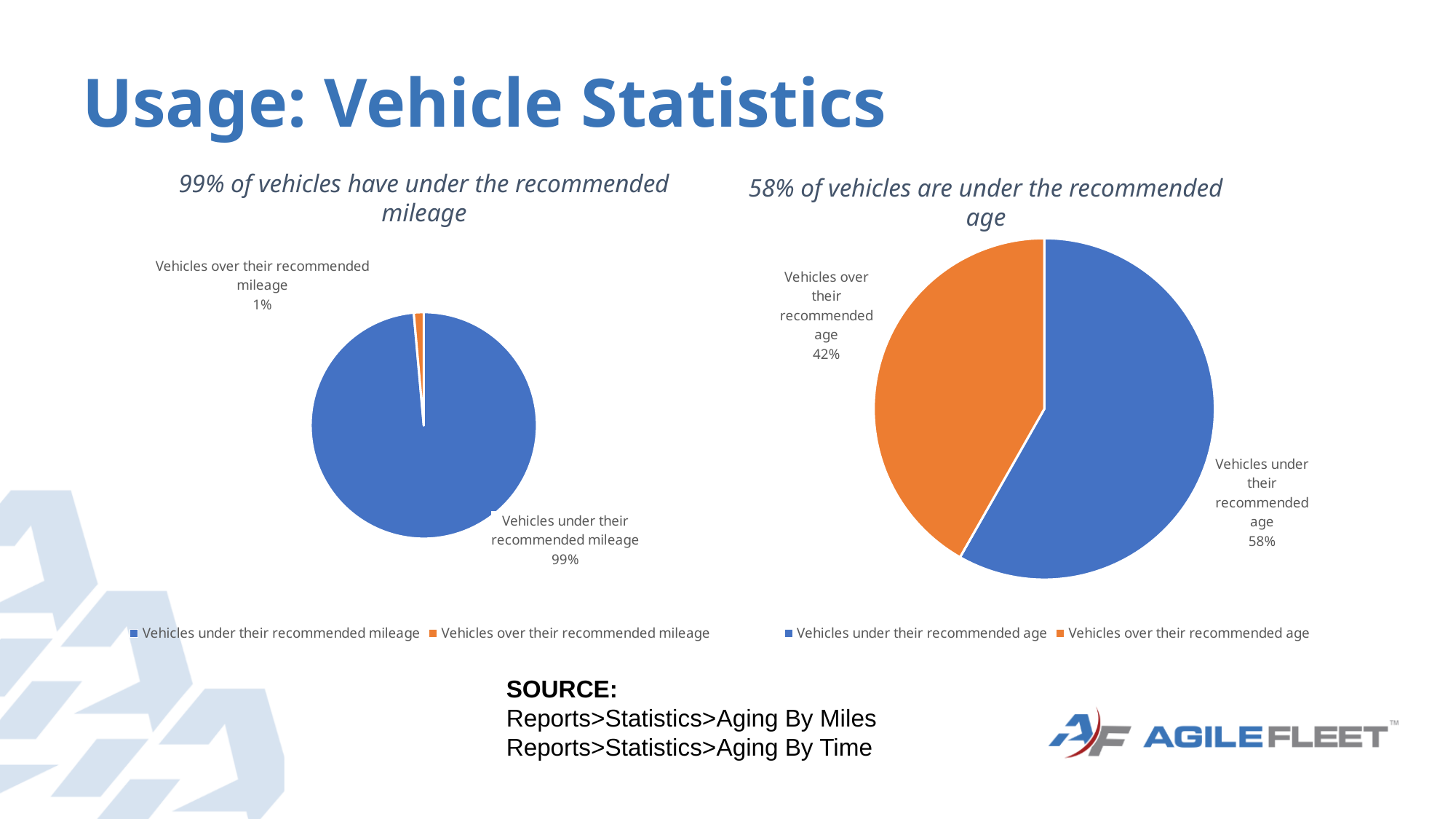
In the right chart (58% of vehicles are under the recommended age), which slice is the largest? Vehicles under their recommended age In the left chart (99% of vehicles have under the recommended mileage), what is the difference in percentage points between vehicles under and over their recommended mileage? 98 In the right chart (58% of vehicles are under the recommended age), what is the difference in percentage points between vehicles under and over their recommended age? 16 How many slices does the right chart (58% of vehicles are under the recommended age) have? 2 What type of chart is the left chart (99% of vehicles have under the recommended mileage)? Pie chart In the right chart (58% of vehicles are under the recommended age), what share of vehicles are over their recommended age? 42% In the left chart (99% of vehicles have under the recommended mileage), what share of vehicles are under their recommended mileage? 99% In the left chart (99% of vehicles have under the recommended mileage), what share of vehicles are over their recommended mileage? 1% In the right chart (58% of vehicles are under the recommended age), which is larger: vehicles under their recommended age or vehicles over their recommended age? Vehicles under their recommended age In the left chart (99% of vehicles have under the recommended mileage), which slice is the smallest? Vehicles over their recommended mileage In the left chart (99% of vehicles have under the recommended mileage), what colour is the slice for vehicles over their recommended mileage? Orange